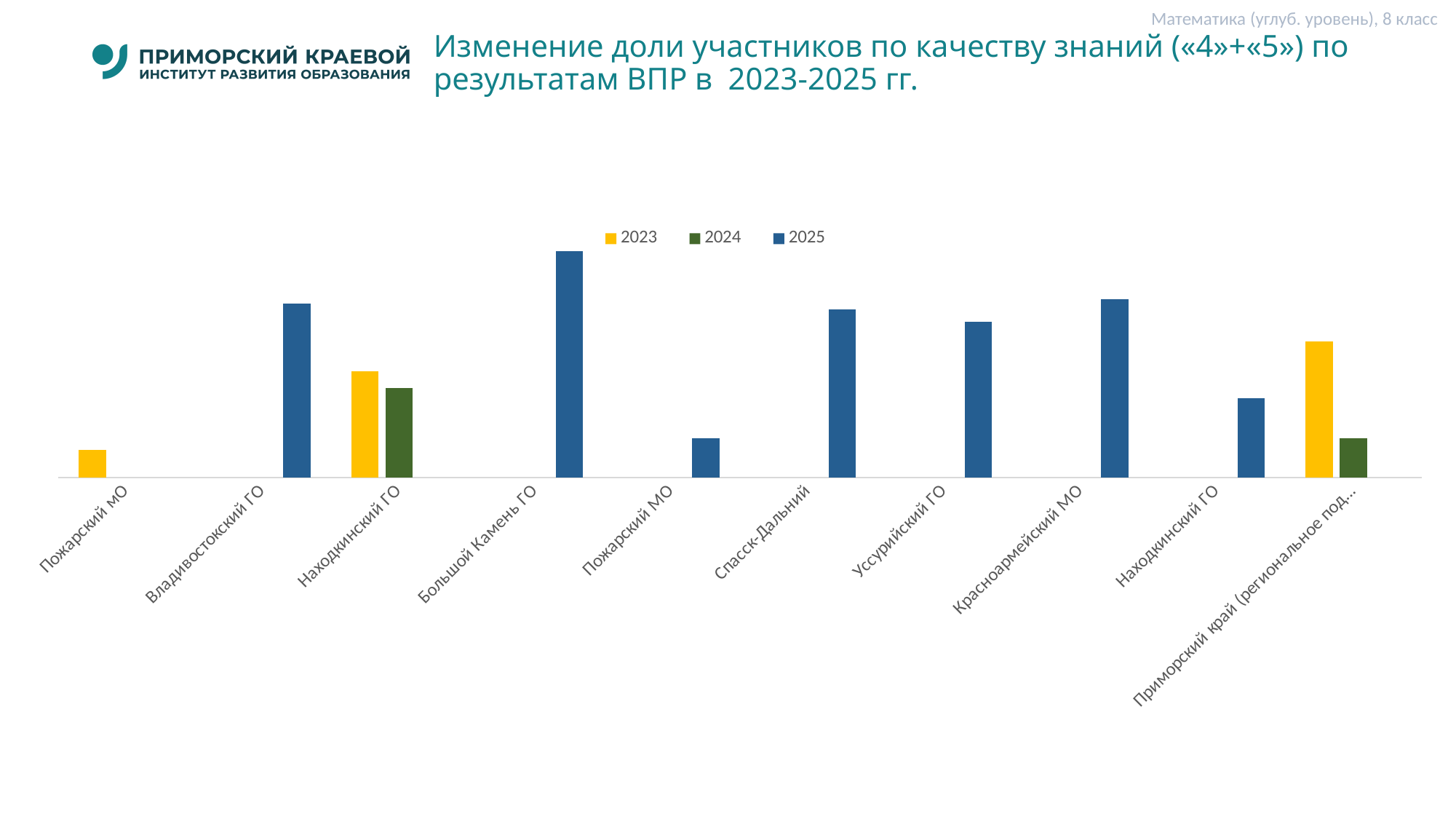
Which years are listed in the legend? 2023, 2024, 2025 Which is larger: the 2025 bar for Большой Камень ГО or the 2025 bar for Находкинский ГО (the ninth category)? Большой Камень ГО For Находкинский ГО (the third category), which is larger: the 2023 bar or the 2024 bar? 2023 What colour represents the 2023 series? yellow What kind of chart is shown on the slide? bar chart How many categories have a 2024 bar? 2 How many categories are shown along the x axis? 10 For Приморский край (региональное под...), which is larger: the 2023 bar or the 2024 bar? 2023 Which category has the lowest 2025 bar? Пожарский МО How many series does the legend list? 3 Which category has the highest 2025 bar? Большой Камень ГО